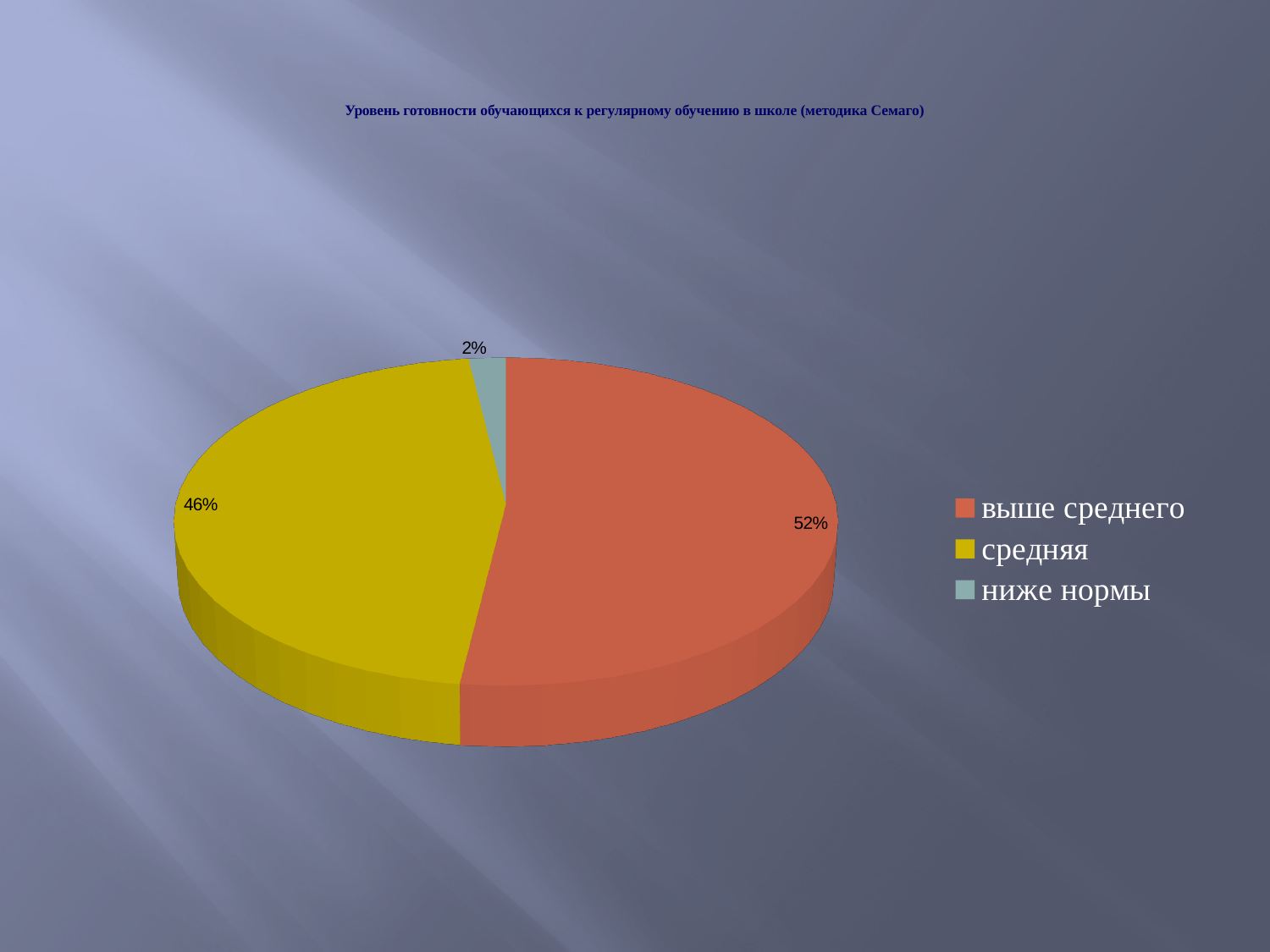
How many slices does the pie chart have? 3 Which category has the largest slice of the pie? выше среднего What colour is the 'средняя' slice in the pie chart? yellow What share of the pie does the 'средняя' slice represent? 46% Which category has the smallest slice of the pie? ниже нормы Which is larger, the 'средняя' slice or the 'ниже нормы' slice? средняя What share of the pie does the 'выше среднего' slice represent? 52% What is the difference in percentage points between the 'средняя' and 'ниже нормы' slices? 44 What kind of chart is shown on the slide? pie chart What share of the pie does the 'ниже нормы' slice represent? 2% What is the title of the chart? Уровень готовности обучающихся к регулярному обучению в школе (методика Семаго) What is the difference in percentage points between the 'выше среднего' and 'средняя' slices? 6